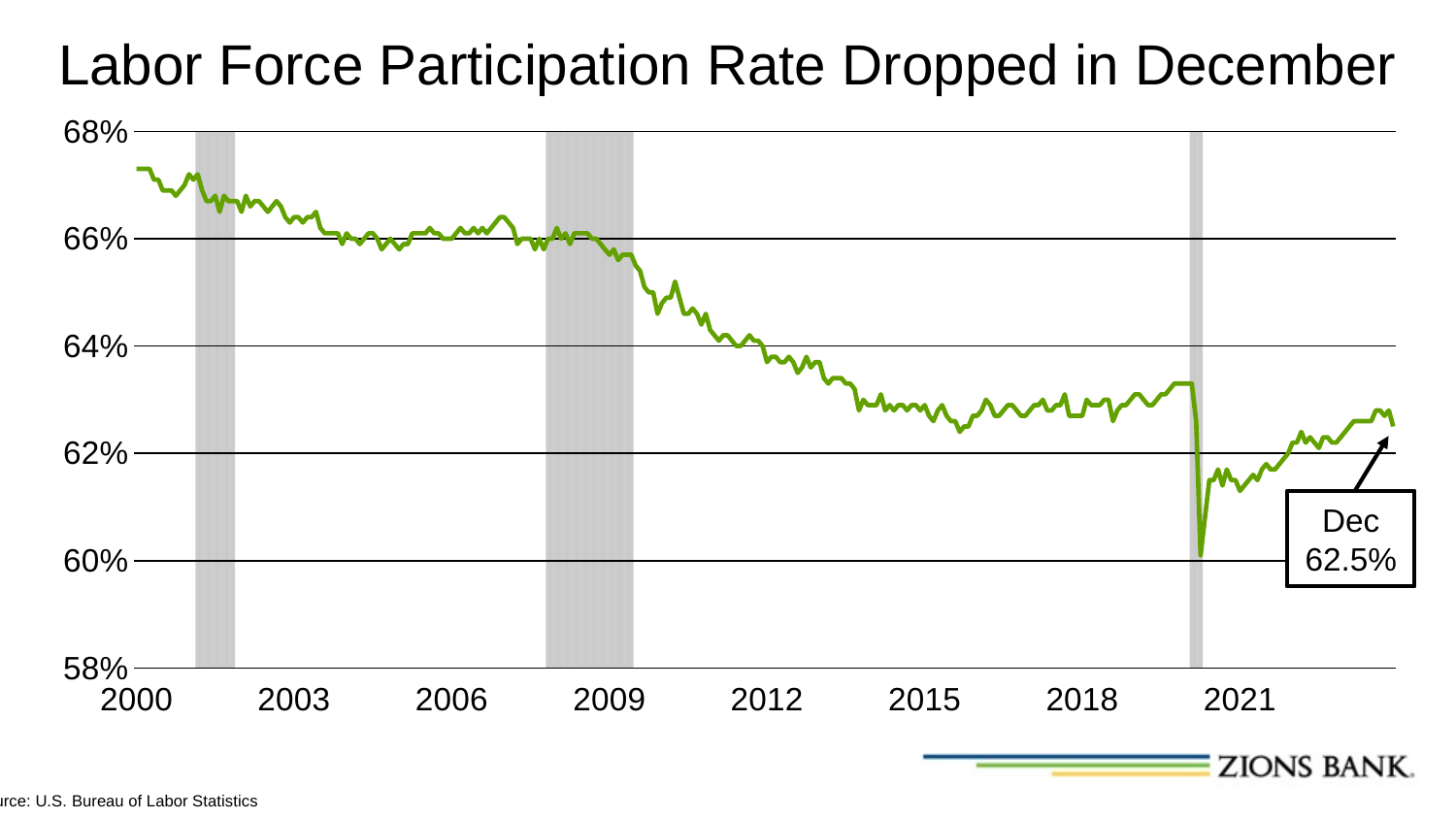
Is the lowest point of the line, in 2020, greater or less than 62%? less Is the December value of 62.5% greater or less than the rate at the start of 2000? less What is the title of the chart? Labor Force Participation Rate Dropped in December What is the labor force participation rate shown for December in the data label? 62.5% In which year shown on the x axis does the line reach its highest level? 2000 Is the labor force participation rate in 2018 greater or less than 62%? greater Is the labor force participation rate in 2015 greater or less than 64%? less Overall, does the labor force participation rate rise or fall from 2000 to the end of the series? fall How many shaded vertical bands (recession periods) are shown on the chart? 3 Around which year does the line drop to its lowest level? 2020 What kind of chart is shown on the slide? line chart